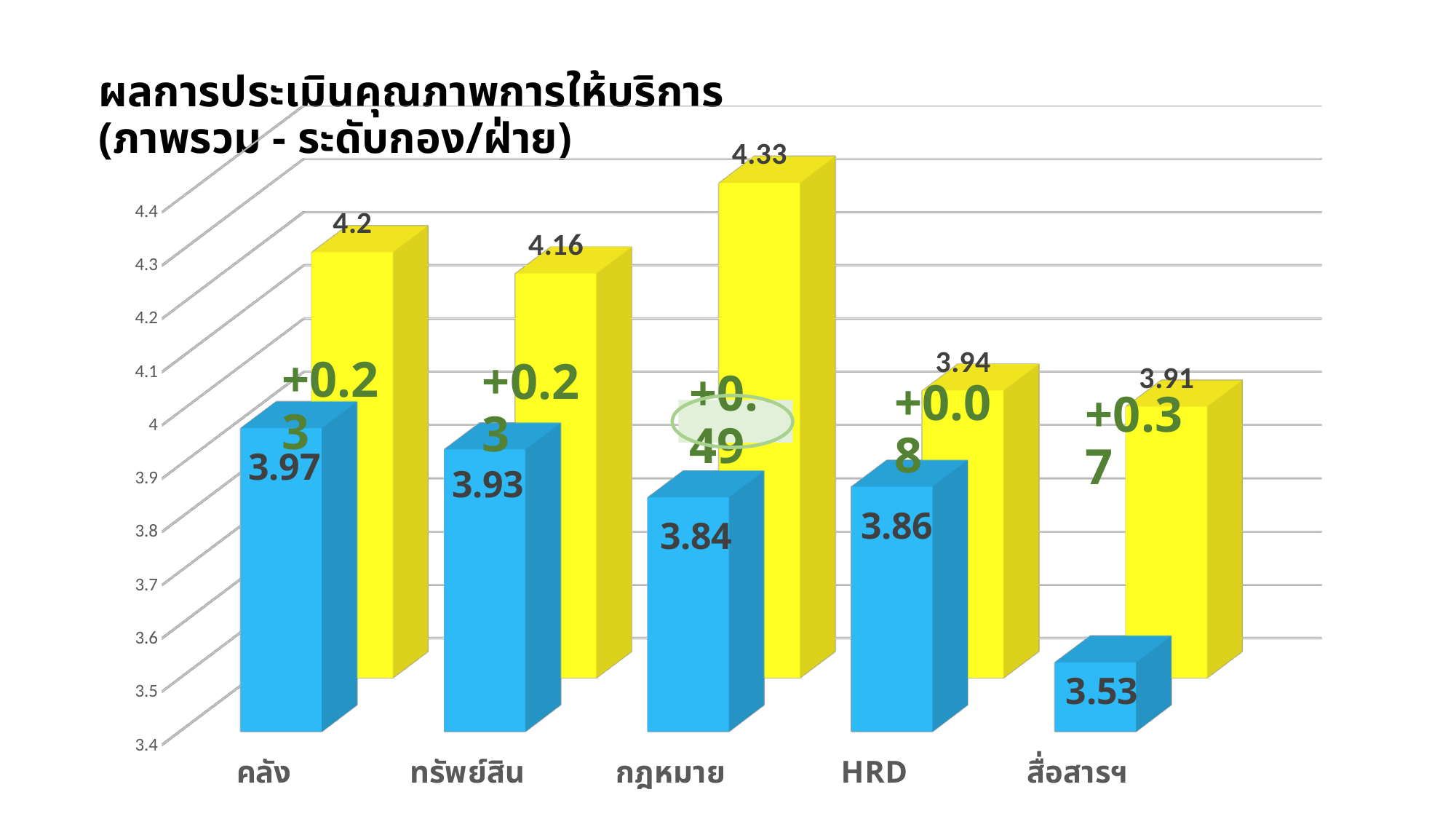
How many categories are shown on the x axis? 5 What is the difference between the yellow and blue bars for สื่อสารฯ? 0.38 What is the difference between the yellow and blue bars for กฎหมาย? 0.49 What is the value of the yellow bar for กฎหมาย? 4.33 What is the value of the blue bar for สื่อสารฯ? 3.53 What kind of chart is shown on the slide? Bar chart What is the value of the blue bar for คลัง? 3.97 Which category has the highest yellow bar? กฎหมาย Which is larger, the blue bar for ทรัพย์สิน or the blue bar for HRD? ทรัพย์สิน Which category has the lowest blue bar? สื่อสารฯ What is the value of the yellow bar for HRD? 3.94 What is the title of the chart? ผลการประเมินคุณภาพการให้บริการ (ภาพรวม - ระดับกอง/ฝ่าย)